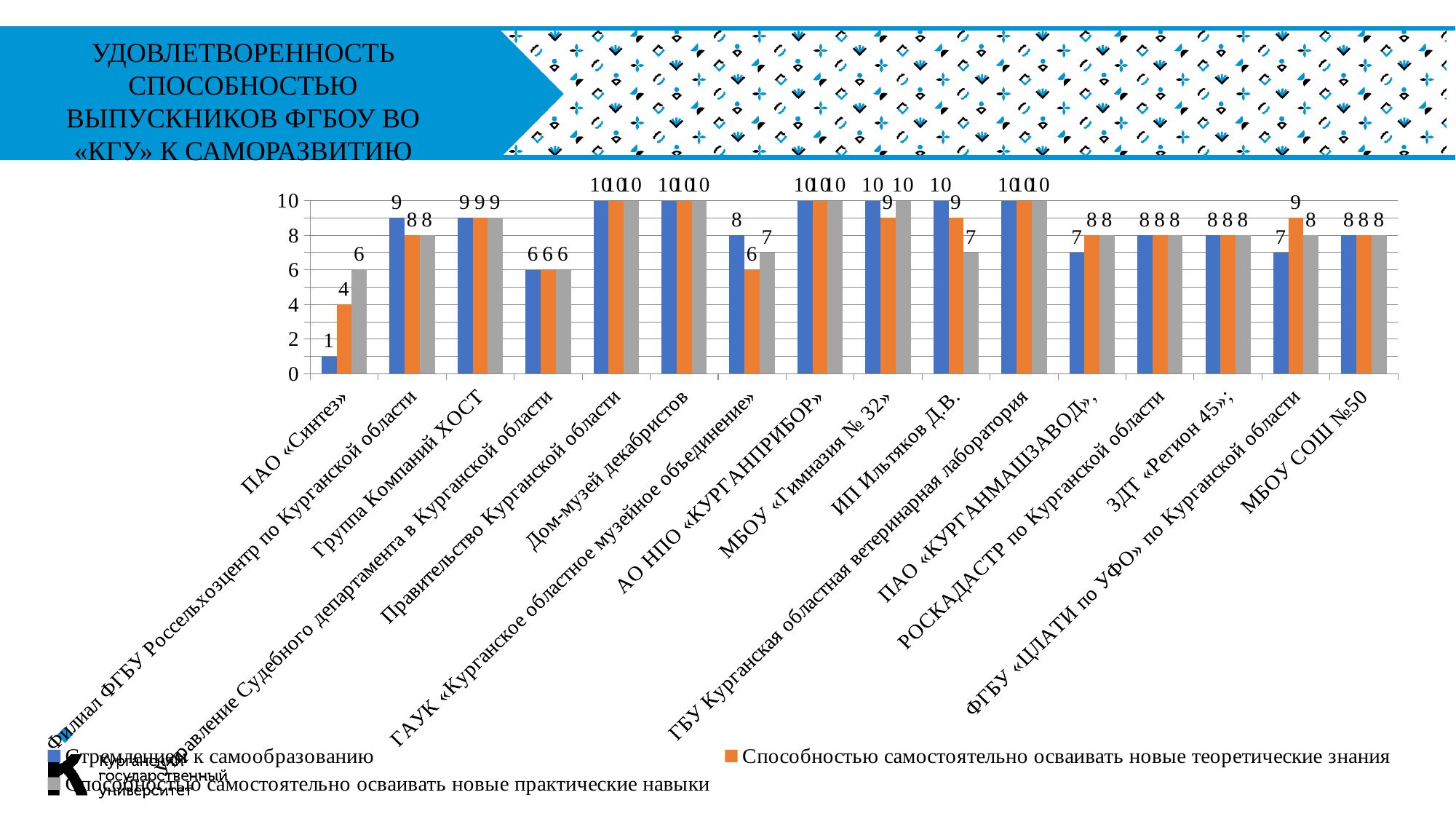
How many series does the legend list? 3 For ФГБУ «ЦЛАТИ по УФО» по Курганской области, which is larger: «Стремлением к самообразованию» or «Способностью самостоятельно осваивать новые теоретические знания»? Способностью самостоятельно осваивать новые теоретические знания What is the value of «Стремлением к самообразованию» for ПАО «КУРГАНМАШЗАВОД»? 7 What is the value of «Способностью самостоятельно осваивать новые теоретические знания» for ГАУК «Курганское областное музейное объединение»? 6 What is the difference between the «Способностью самостоятельно осваивать новые практические навыки» value and the «Стремлением к самообразованию» value for ПАО «Синтез»? 5 Which organisation has the lowest value for «Стремлением к самообразованию»? ПАО «Синтез» What is the value of «Стремлением к самообразованию» for ПАО «Синтез»? 1 How many organisations (categories) are shown on the x axis? 16 What is the value of «Способностью самостоятельно осваивать новые практические навыки» for ИП Ильтяков Д.В.? 7 Which colour represents the series «Способностью самостоятельно осваивать новые теоретические знания»? orange What type of chart is shown on the slide? bar chart What is the value of «Способностью самостоятельно осваивать новые практические навыки» for ПАО «Синтез»? 6